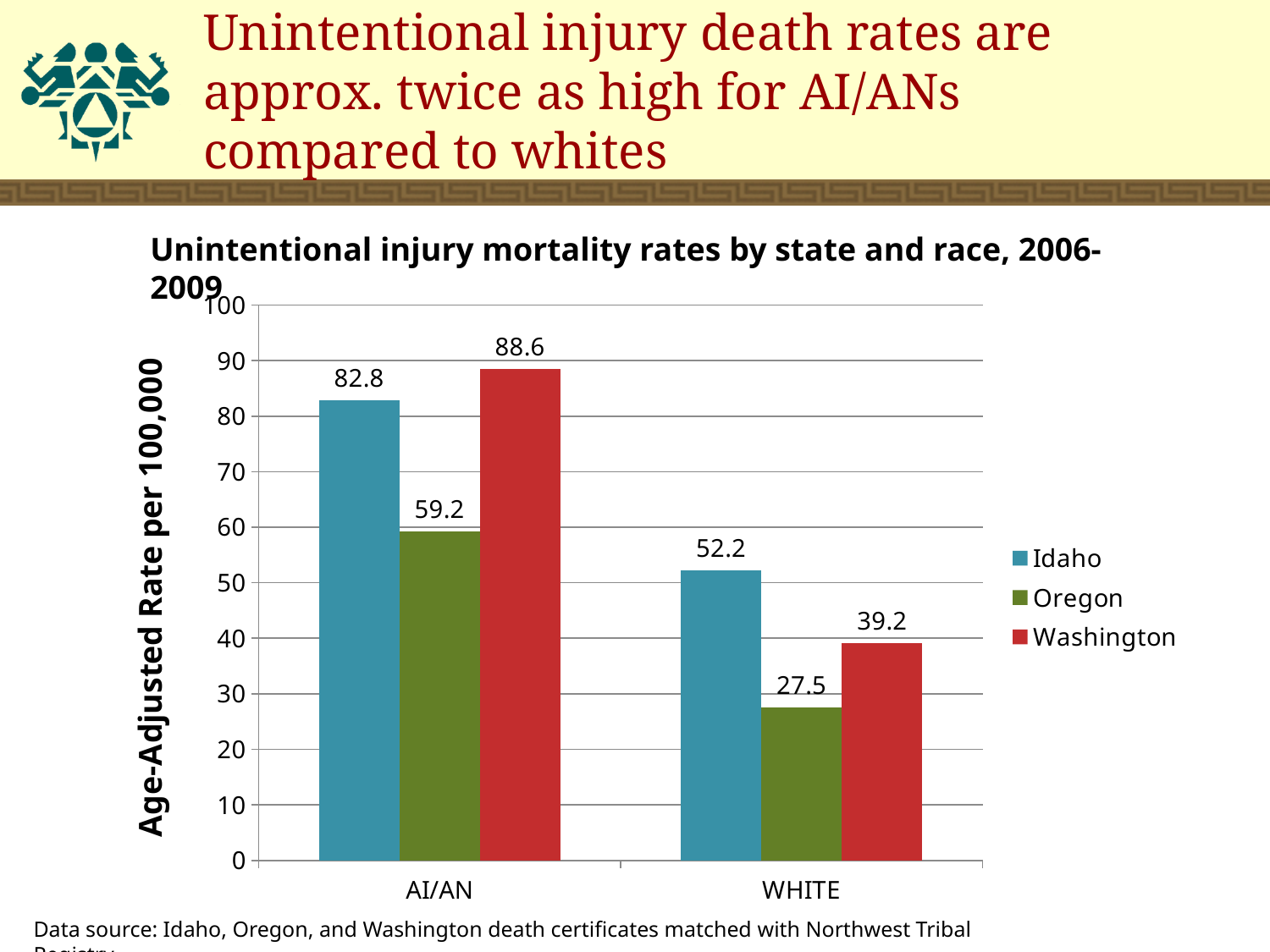
What is the difference between the Idaho rates for AI/AN and WHITE? 30.6 Which state has the highest rate in the AI/AN category? Washington Is the Washington rate for WHITE greater or less than 40? less What is the unintentional injury mortality rate for AI/AN in Idaho? 82.8 What is the difference between the Washington and Oregon rates for AI/AN? 29.4 Which is larger: the Oregon rate for AI/AN or the Idaho rate for WHITE? Oregon rate for AI/AN How many series does the legend list? 3 Which state has the lowest rate in the WHITE category? Oregon What is the unintentional injury mortality rate for WHITE in Oregon? 27.5 What is the value for Washington in the AI/AN category? 88.6 How many race categories are shown on the x axis? 2 What kind of chart is shown on the slide? Bar chart